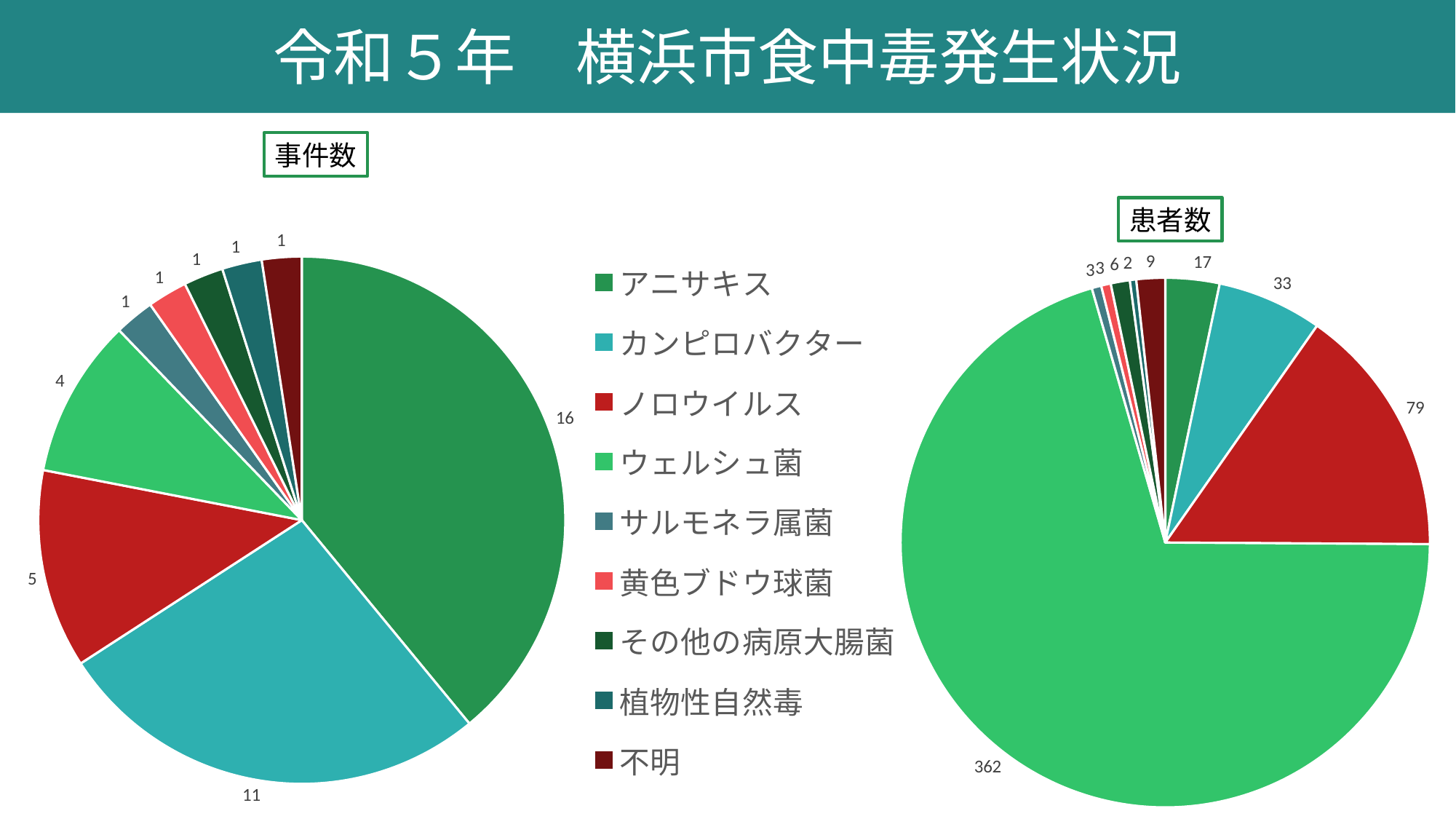
In the 患者数 pie chart, which is larger, the value for アニサキス or the value for ノロウイルス? ノロウイルス How many entries does the legend list? 9 In the 事件数 pie chart, what is the value for アニサキス? 16 What kind of charts are shown on the slide? Pie charts In the 患者数 pie chart, what is the value for ウェルシュ菌? 362 In the 患者数 pie chart, which category has the largest slice? ウェルシュ菌 In the 患者数 pie chart, what is the difference between the values for ノロウイルス and カンピロバクター? 46 In the 事件数 pie chart, which category has the largest slice? アニサキス In the 患者数 pie chart, what is the value for カンピロバクター? 33 In the 事件数 pie chart, what is the difference between the values for アニサキス and カンピロバクター? 5 In the 事件数 pie chart, what is the value for カンピロバクター? 11 In the 患者数 pie chart, what is the value for ノロウイルス? 79